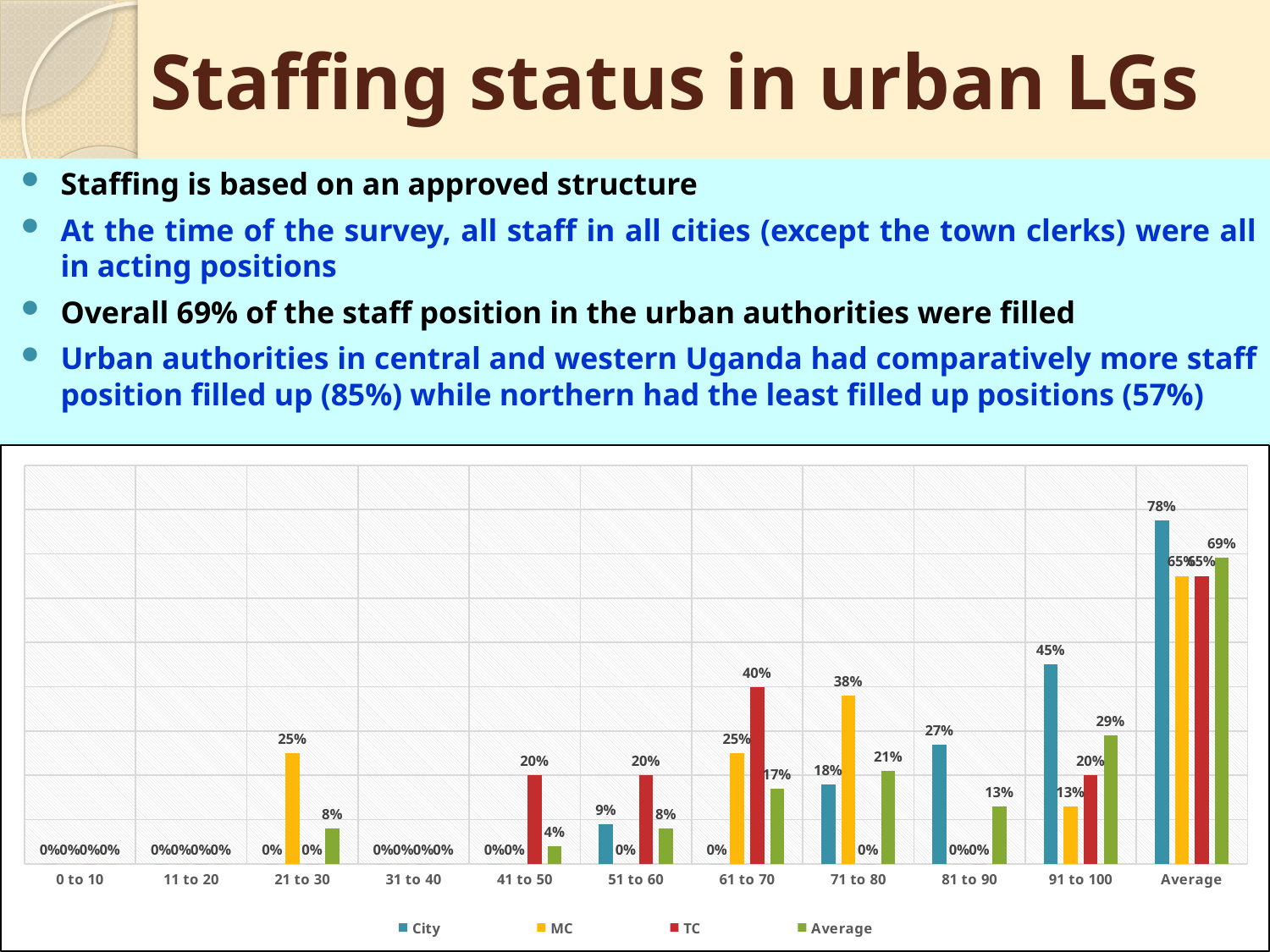
What is the difference between the TC value and the City value in the 51 to 60 category? 11% What type of chart is shown on the slide? bar chart Which is larger in the 91 to 100 category, the City value or the TC value? City What is the value for the Average series in the 91 to 100 category? 29% Which category has the highest value for the City series? Average What is the value for TC in the 61 to 70 category? 40% What is the value for City in the Average category? 78% How many categories are shown along the x axis of the chart? 11 What is the value for MC in the 71 to 80 category? 38% What is the difference between the City value and the MC value in the Average category? 13% How many series does the chart legend list? 4 Which series is shown in red in the chart legend? TC